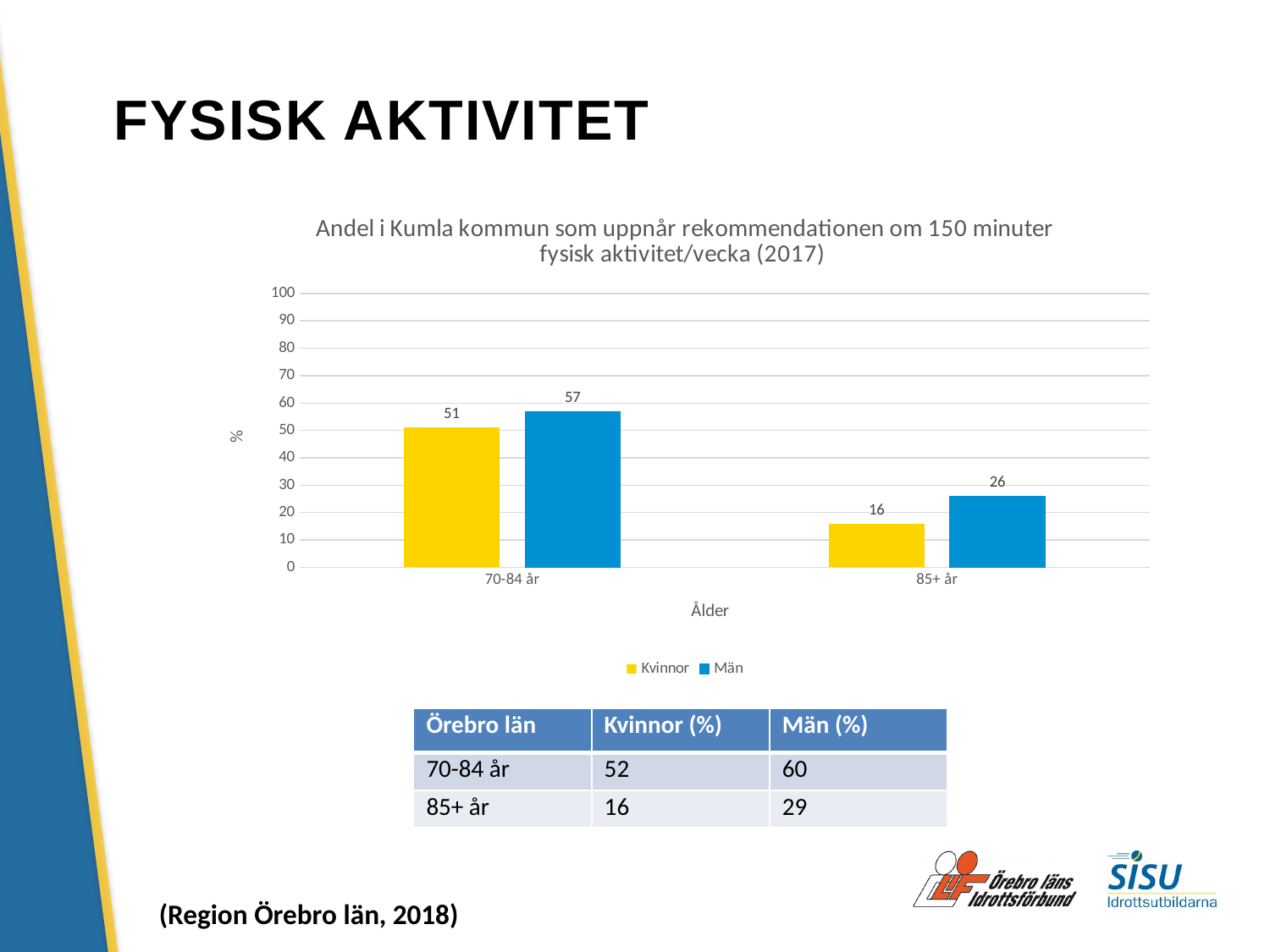
Which bar has the lowest value in the chart? Kvinnor, 85+ år Which series has the highest value in the chart? Män (70-84 år) What is the difference between Män and Kvinnor in the 85+ år category? 10 What is the value for Kvinnor in the 85+ år category? 16 How many series does the legend list? 2 What is the difference between Män and Kvinnor in the 70-84 år category? 6 What is the value for Män in the 85+ år category? 26 What is the value for Män in the 70-84 år category? 57 How many age categories are shown on the x axis? 2 What kind of chart is shown on the slide? Bar chart Which is larger, the value for Kvinnor at 70-84 år or the value for Män at 85+ år? Kvinnor at 70-84 år What is the value for Kvinnor in the 70-84 år category? 51